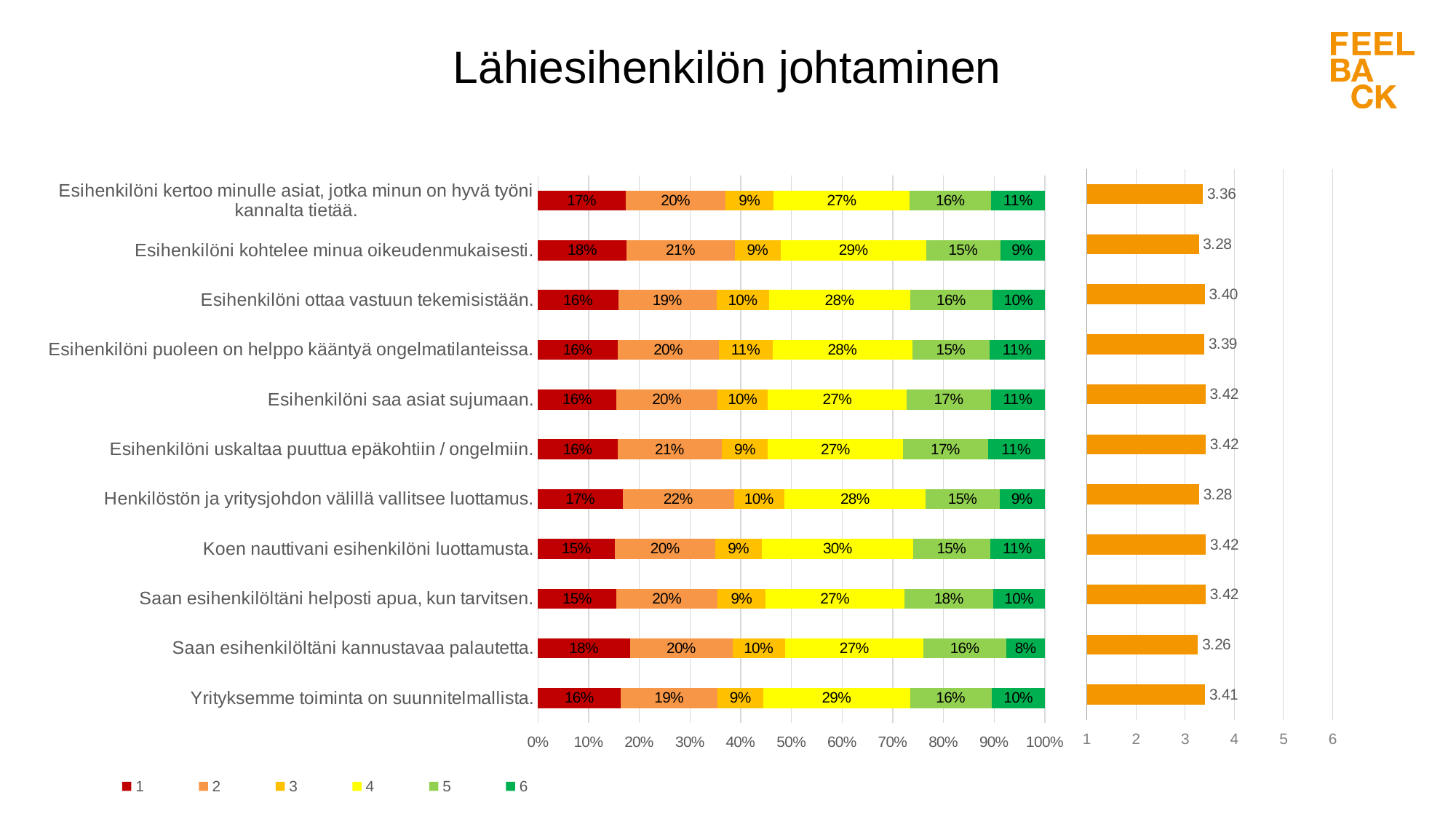
How many statements are shown in the stacked bar chart on the left? 11 What kind of chart is the chart on the right of the slide? Bar chart In the stacked bar chart on the left, which statement has the lowest share in category 6? Saan esihenkilöltäni kannustavaa palautetta. In the stacked bar chart on the left, what percentage of responses for "Esihenkilöni kohtelee minua oikeudenmukaisesti." are in category 4? 29% In the bar chart on the right, what is the difference between the average for "Esihenkilöni saa asiat sujumaan." and the average for "Saan esihenkilöltäni kannustavaa palautetta."? 0.16 In the stacked bar chart on the left, which statement has the highest share in category 4? Koen nauttivani esihenkilöni luottamusta. How many series does the legend of the stacked bar chart on the left list? 6 In the bar chart on the right, what is the average value for "Esihenkilöni ottaa vastuun tekemisistään."? 3.40 In the stacked bar chart on the left, what percentage of responses for "Saan esihenkilöltäni kannustavaa palautetta." are in category 6? 8% In the bar chart on the right, which statement has the lowest average value? Saan esihenkilöltäni kannustavaa palautetta. In the stacked bar chart on the left, which is larger for "Henkilöstön ja yritysjohdon välillä vallitsee luottamus.": the share in category 2 or the share in category 5? Category 2 In the bar chart on the right, is the average for "Esihenkilöni kertoo minulle asiat, jotka minun on hyvä työni kannalta tietää." greater or less than 4? less